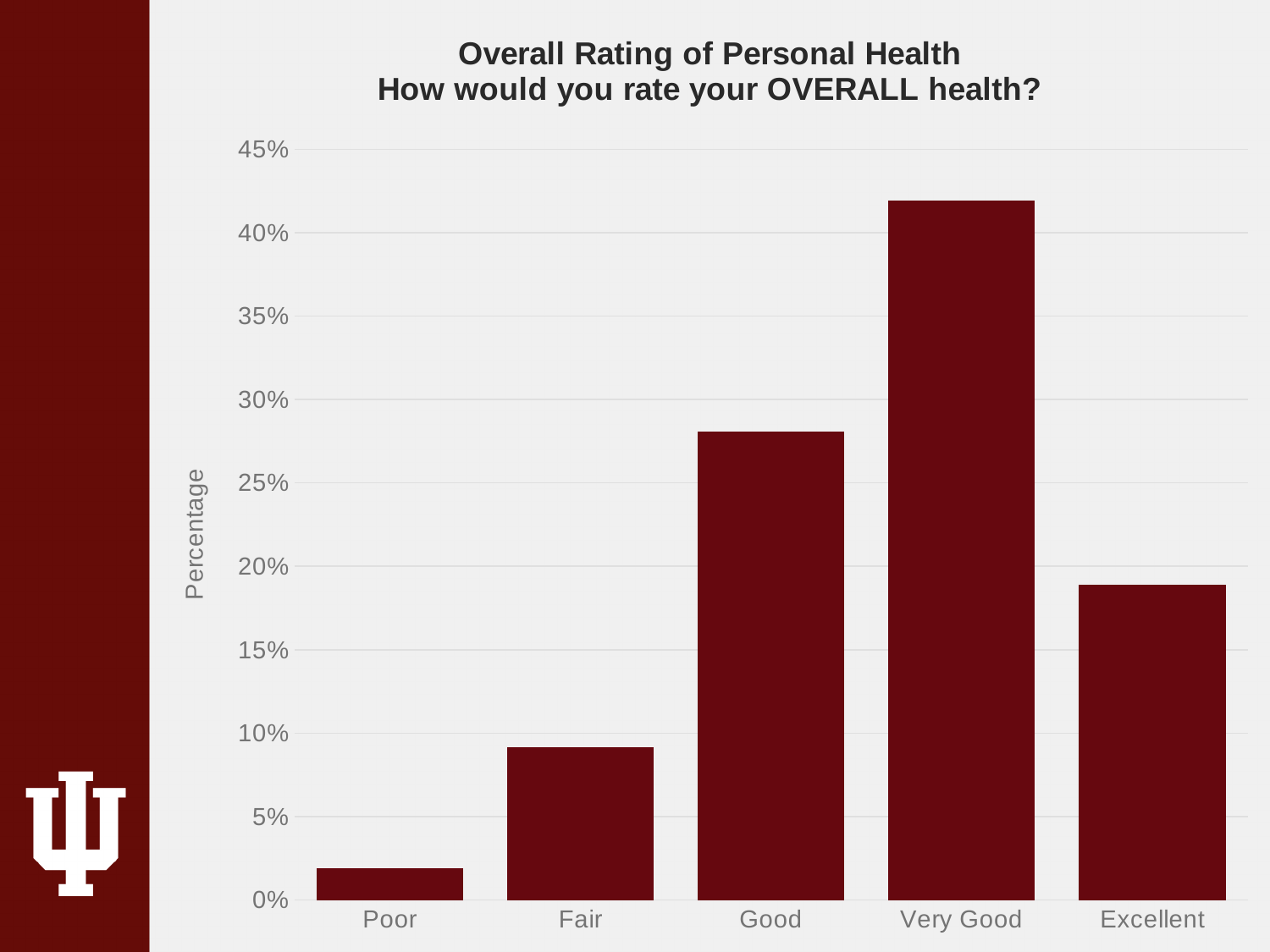
What is the label on the vertical axis of the chart? Percentage Which is larger, the percentage for Fair or the percentage for Poor? Fair What kind of chart is shown on the slide? bar chart Is the value for Very Good greater or less than 40%? greater Is the value for Excellent greater or less than 25%? less Is the value for Fair greater or less than 15%? less How many health rating categories are shown on the x axis? 5 Which health rating category has the highest percentage? Very Good Which health rating category has the lowest percentage? Poor Which is larger, the percentage for Good or the percentage for Excellent? Good